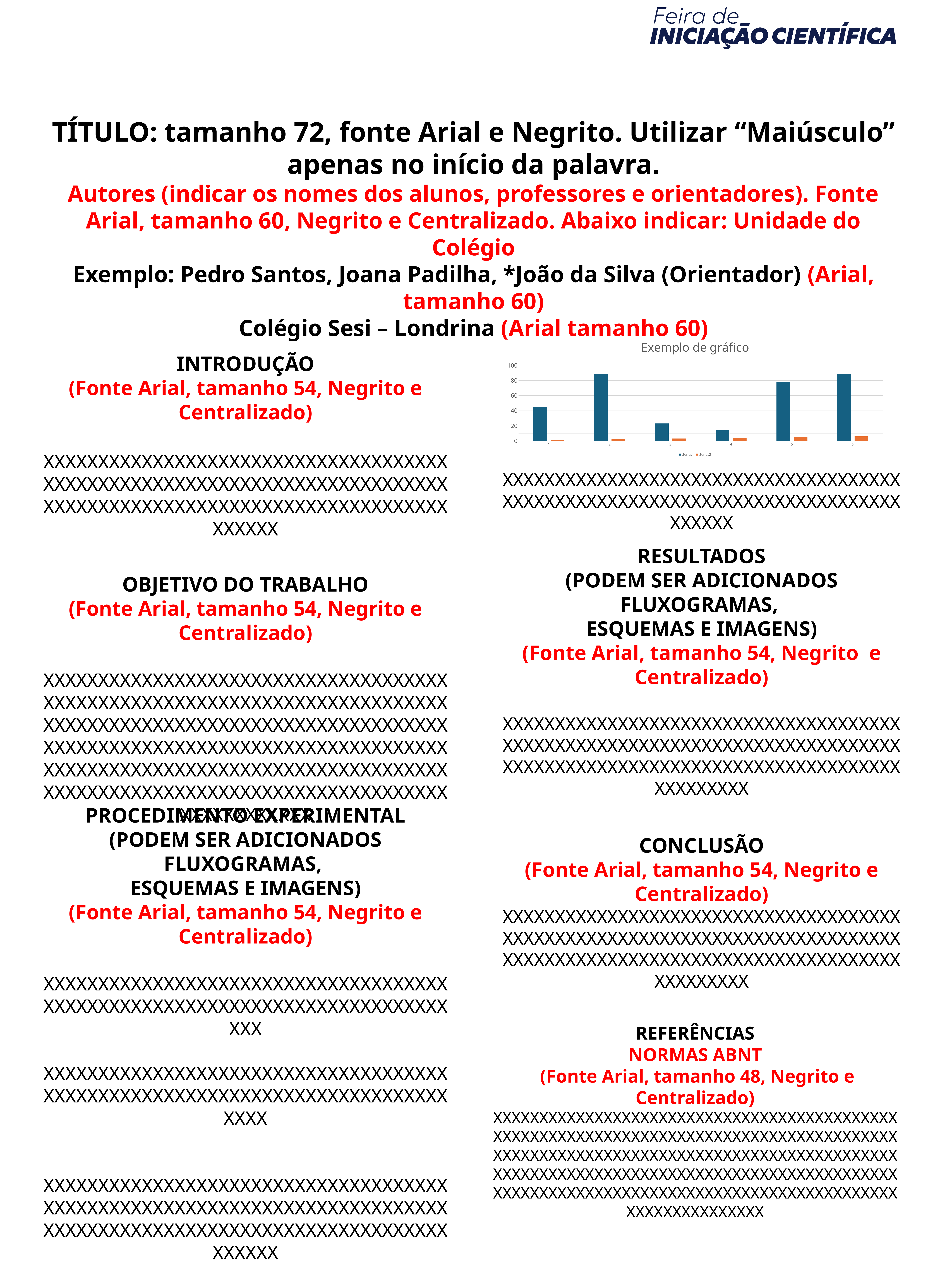
How many categories are shown on the x axis of the chart? 6 What kind of chart is shown on the slide? bar chart Is the Series1 value for category 4 greater or less than 20? less Which has the larger Series1 value, category 2 or category 3? category 2 Which category has the lowest Series1 value? 4 Is the Series1 value for category 2 greater or less than 80? greater Is the Series1 value for category 3 greater or less than 40? less How many series does the chart's legend list? 2 What are the names of the series listed in the chart's legend? Series1 and Series2 For category 1, which series has the larger value, Series1 or Series2? Series1 What is the title of the chart on the slide? Exemplo de gráfico